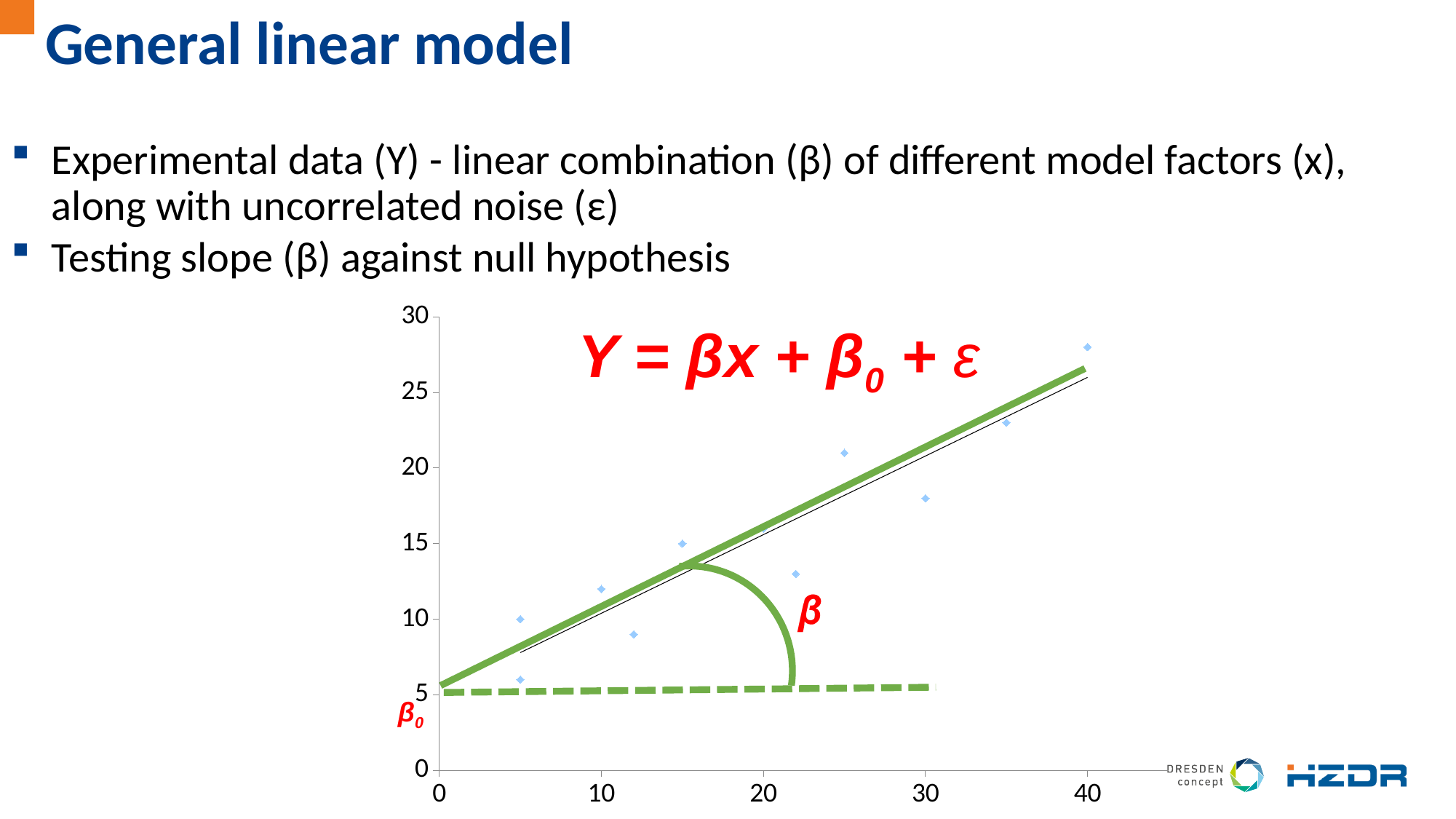
Is the value of the data point at x = 40 greater or less than 25? greater What is the highest tick value shown on the y axis? 30 Do the plotted values generally rise or fall as x increases? rise Is the value of the data point at x = 30 greater or less than 15? greater At which x value is the highest plotted data point located? 40 Which data point is higher: the one at x = 40 or the one at x = 30? the one at x = 40 Is the value of the data point at about x = 22 greater or less than 15? less What kind of chart is shown on the slide? scatter chart What equation is written in red on the chart? Y = βx + β0 + ε